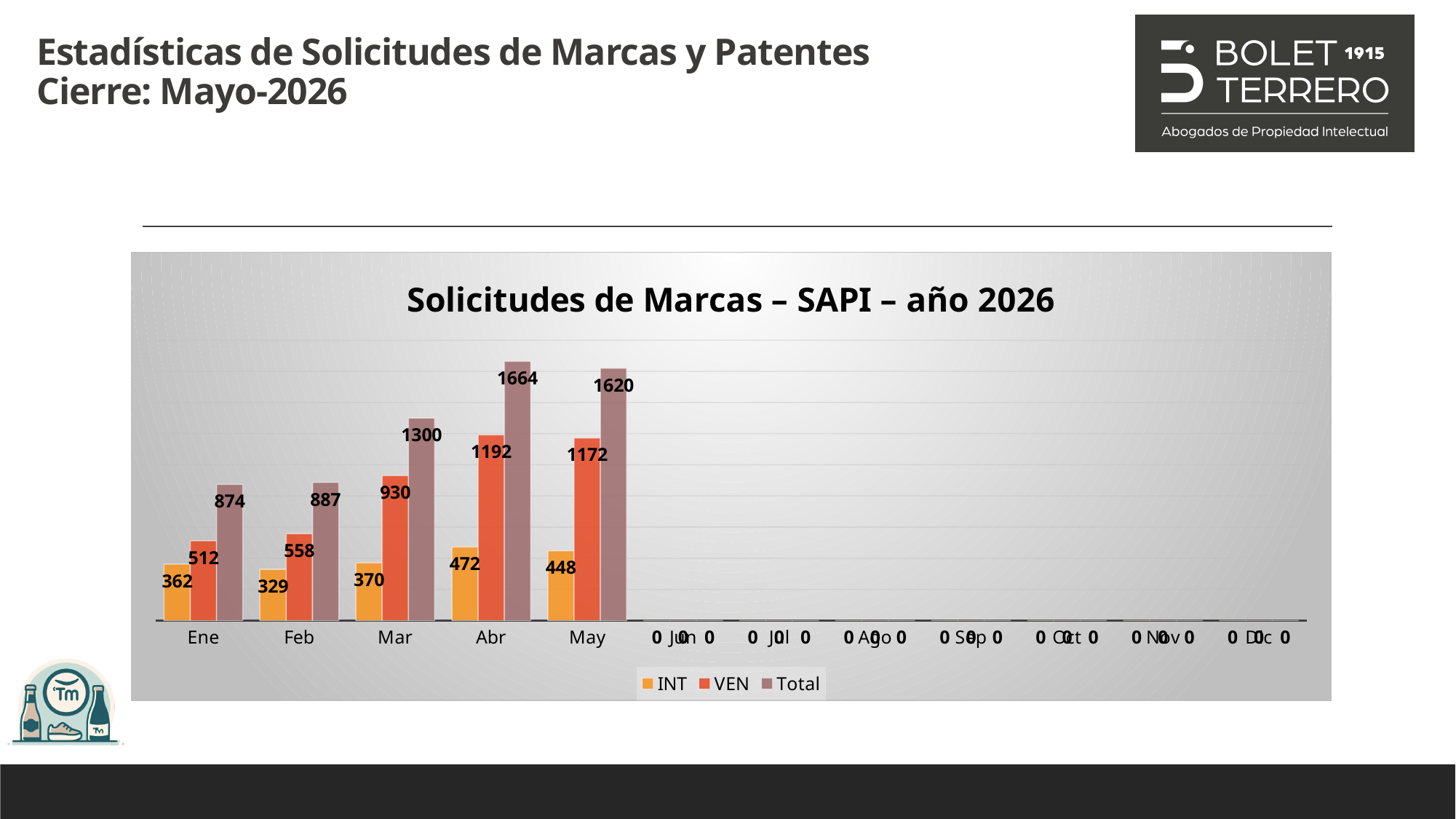
Does the Total series rise or fall from Ene to Abr? Rise What is the INT value for Feb? 329 How many months are shown on the x axis? 12 What is the value of the Total series for Abr? 1664 What is the VEN value for Mar? 930 Which month has the highest Total value? Abr What kind of chart is shown on the slide? Bar chart How many series does the legend list? 3 What is the difference between the Total for Abr and the Total for May? 44 What is the title of the chart? Solicitudes de Marcas – SAPI – año 2026 Which is larger, the VEN value for Feb or the VEN value for Mar? Mar Among the months Ene to May, which month has the lowest INT value? Feb